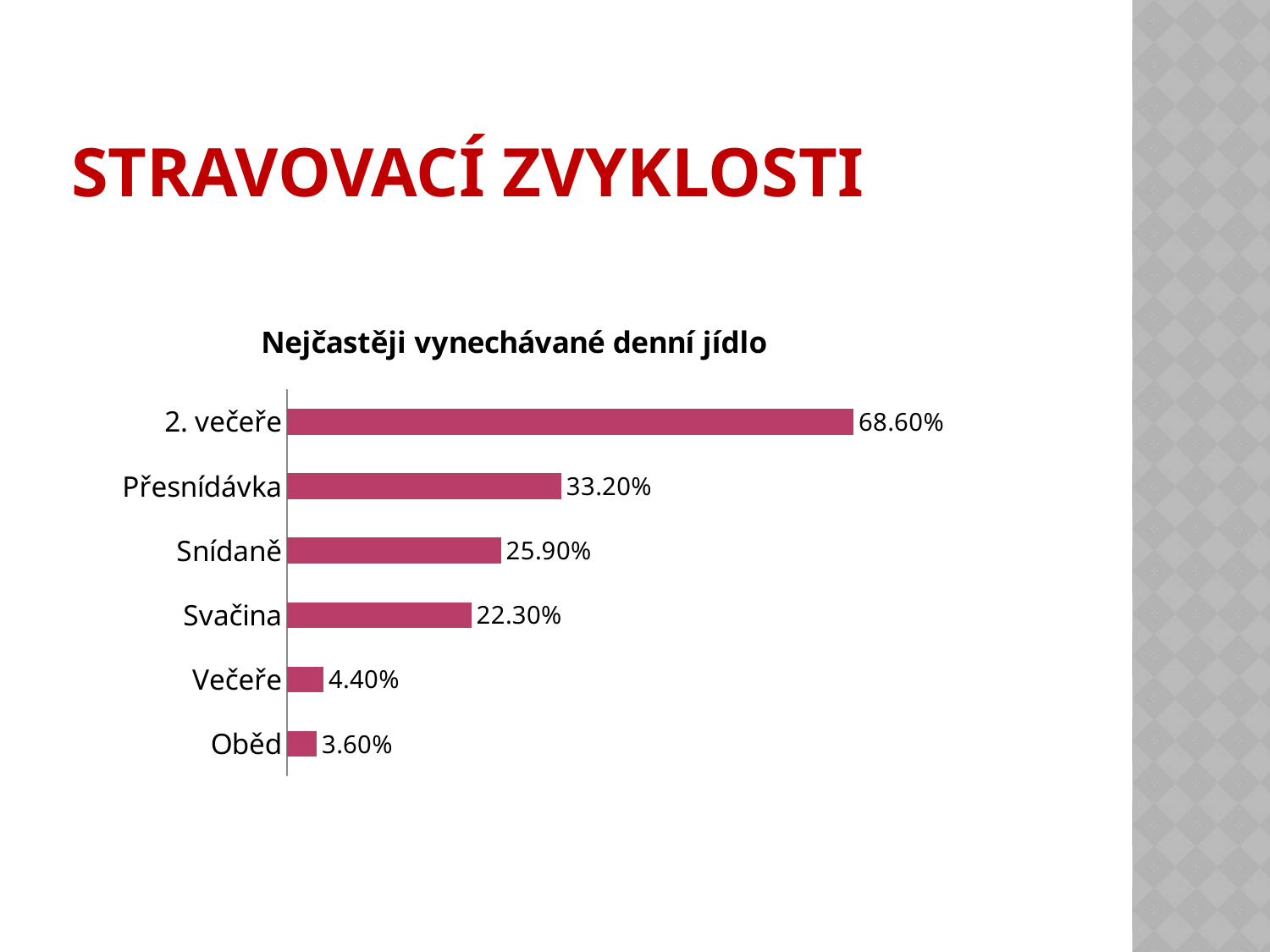
What is the value for 2. večeře? 68.60% What is the value for Svačina? 22.30% Which category has the highest value? 2. večeře What is the value for Přesnídávka? 33.20% How many categories are shown in the chart? 6 What is the difference between the values for 2. večeře and Přesnídávka? 35.40% What is the value for Snídaně? 25.90% What kind of chart is shown on the slide? Bar chart Which category has the lowest value? Oběd Which is larger, the value for Snídaně or the value for Svačina? Snídaně What is the difference between the values for Večeře and Oběd? 0.80% What is the value for Oběd? 3.60%